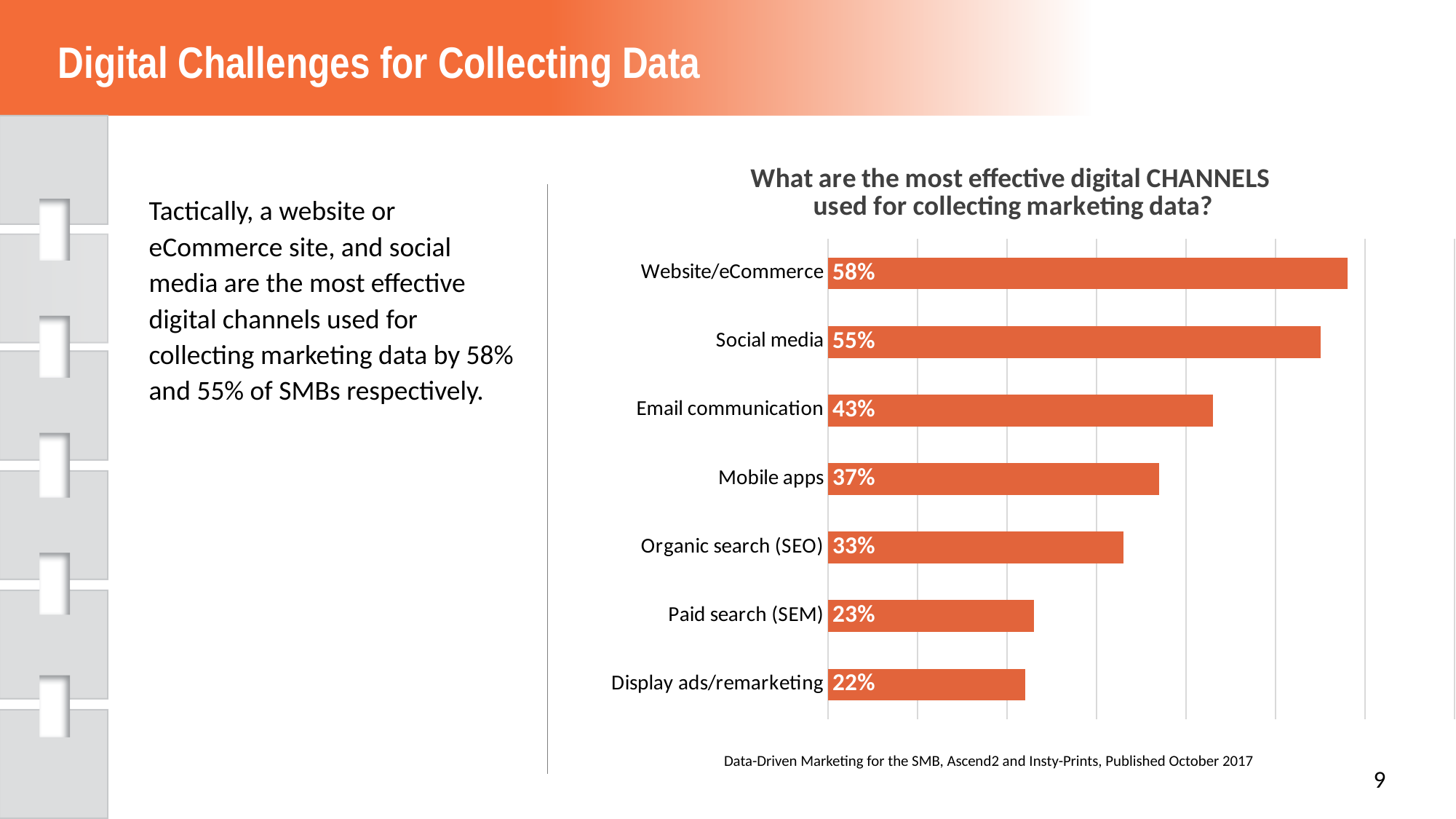
What is the value for Email communication? 43% Which is larger, the value for Mobile apps or the value for Organic search (SEO)? Mobile apps How many channels are shown in the chart? 7 Which channel has the lowest value? Display ads/remarketing What is the difference between the values for Email communication and Organic search (SEO)? 10% Which channel has the highest value? Website/eCommerce What is the value for Paid search (SEM)? 23% What is the value for Website/eCommerce? 58% What is the difference between the values for Social media and Mobile apps? 18% What kind of chart is shown on the slide? Bar chart What colour are the bars in the chart? Orange What is the title of the chart? What are the most effective digital CHANNELS used for collecting marketing data?